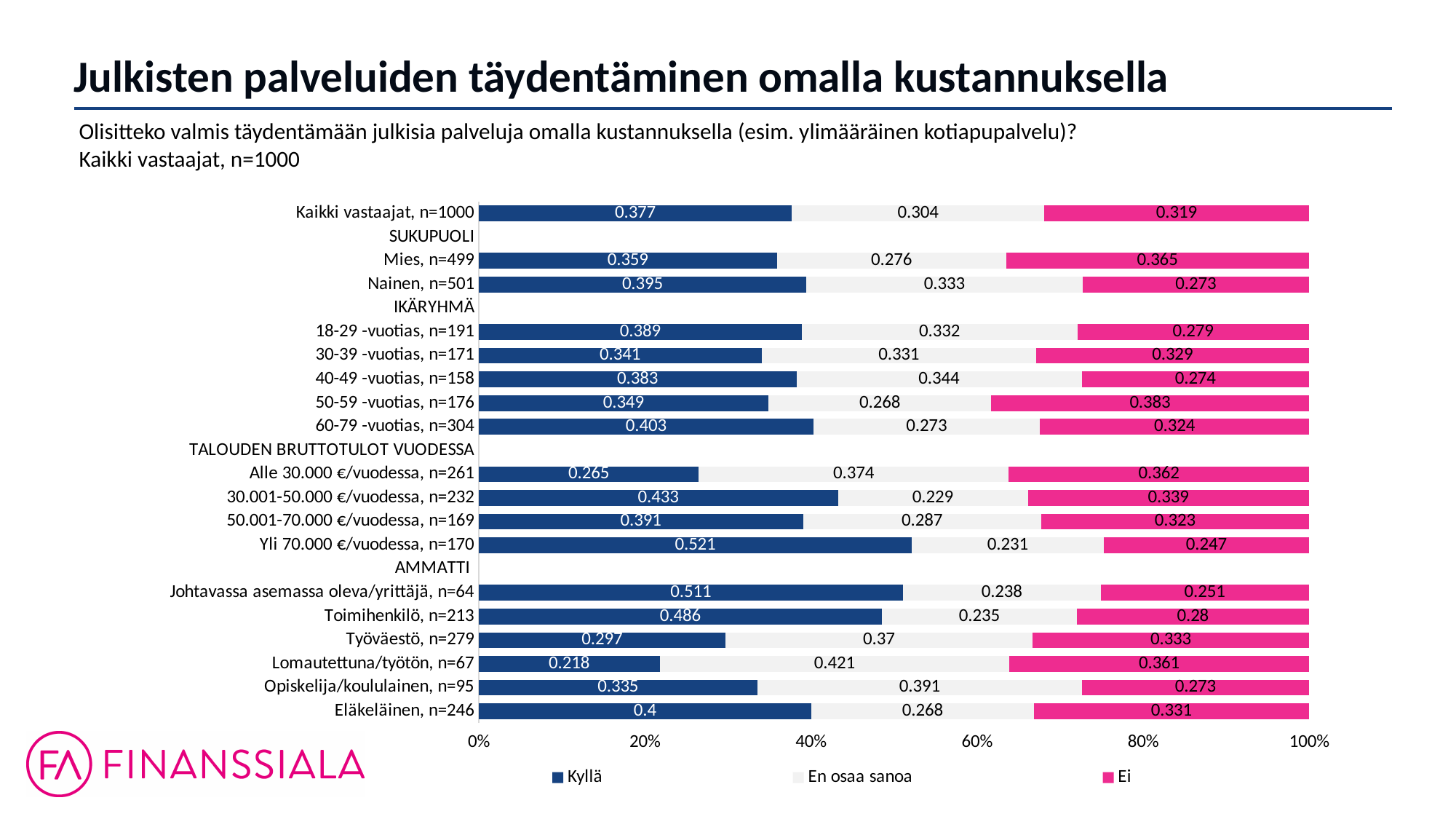
What is the difference between the Kyllä values for Nainen, n=501 and Mies, n=499? 0.036 What is the Ei value for Mies, n=499? 0.365 What is the En osaa sanoa value for Lomautettuna/työtön, n=67? 0.421 Which category has the highest Kyllä value? Yli 70.000 €/vuodessa, n=170 What kind of chart is shown on the slide? stacked bar chart How many series does the legend list? 3 What is the Kyllä value for Kaikki vastaajat, n=1000? 0.377 What is the total of the stacked bar for Eläkeläinen, n=246? 0.999 Is the Kyllä value for Työväestö, n=279 greater or less than 40%? less Which has the larger Ei value: 50-59 -vuotias, n=176 or 18-29 -vuotias, n=191? 50-59 -vuotias, n=176 Which category has the lowest Kyllä value? Lomautettuna/työtön, n=67 What colour represents the Ei series? pink